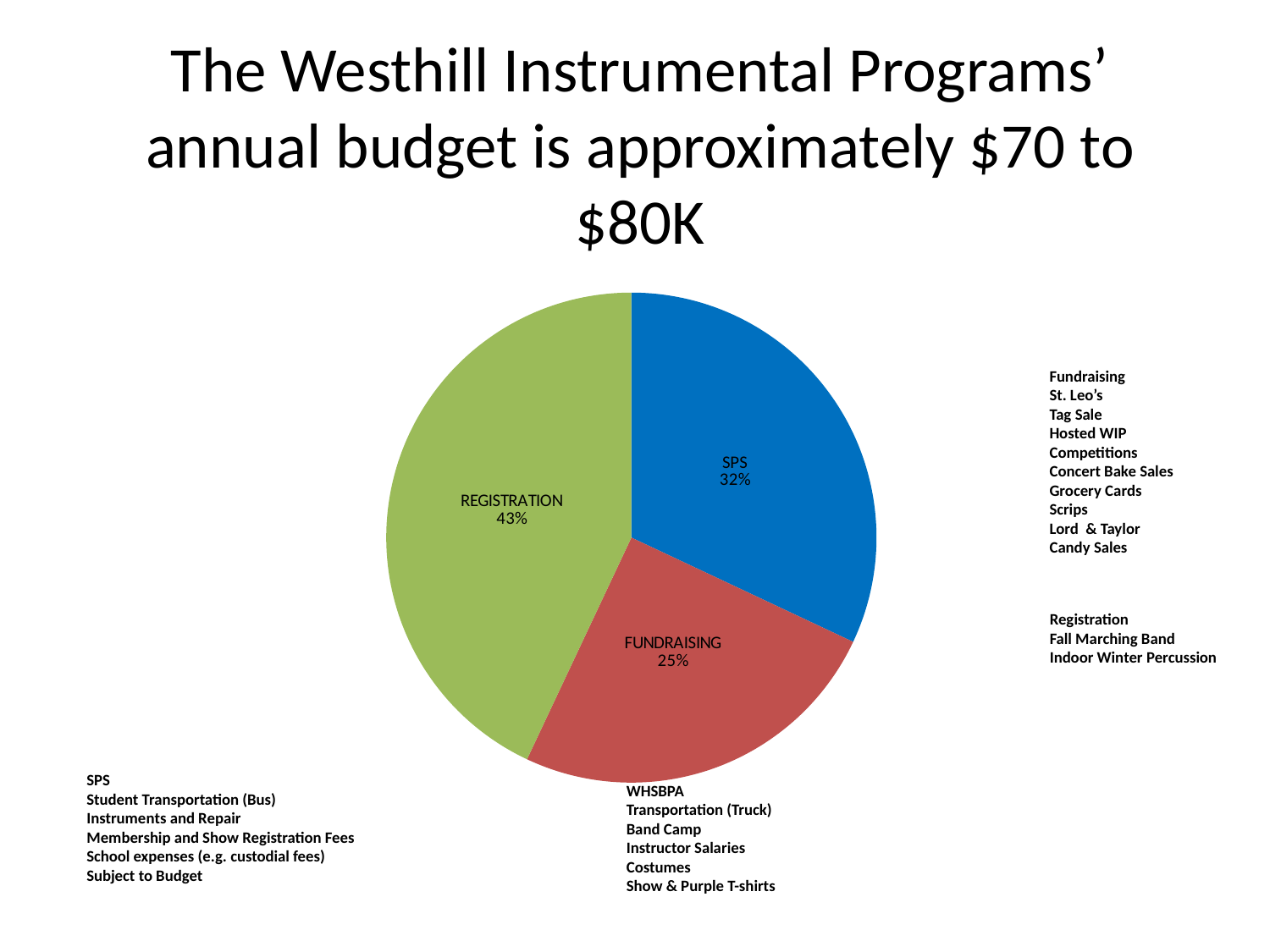
How many slices does the pie chart have? 3 What share of the pie does SPS represent? 32% Which slice of the pie is the largest? REGISTRATION Which slice of the pie is the smallest? FUNDRAISING What is the difference in percentage points between the SPS and FUNDRAISING slices? 7 What colour is the REGISTRATION slice? Green What kind of chart is shown on the slide? Pie chart What share of the pie does REGISTRATION represent? 43% What is the difference in percentage points between the REGISTRATION and SPS slices? 11 What share of the pie does FUNDRAISING represent? 25% What colour is the SPS slice? Blue Which is larger, the SPS slice or the FUNDRAISING slice? SPS